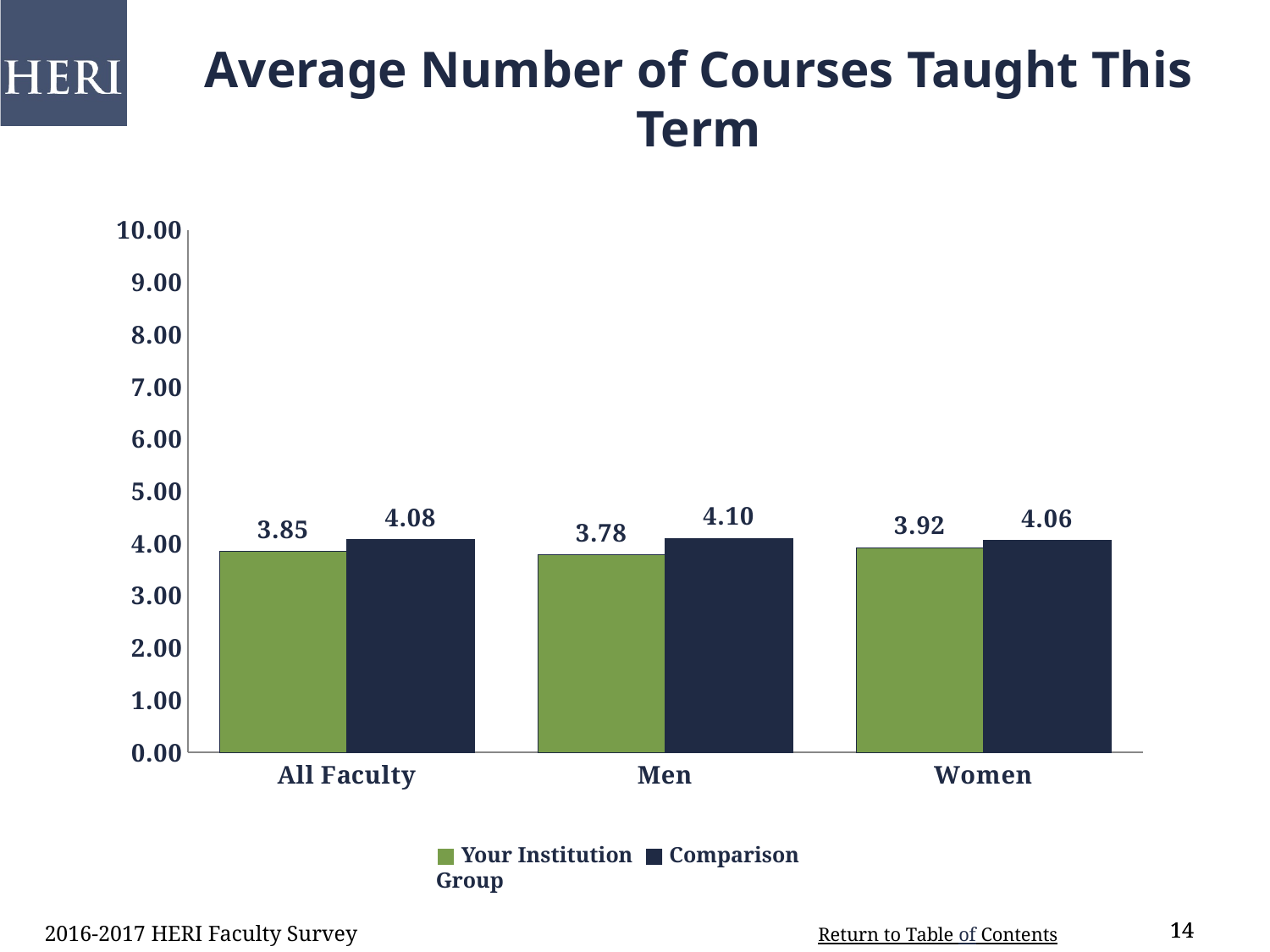
What is the title of the chart? Average Number of Courses Taught This Term How many series does the legend list? 2 What kind of chart is shown on the slide? Bar chart What is the difference between the Comparison Group and Your Institution values for Men? 0.32 For Women, which is larger: Your Institution or Comparison Group? Comparison Group How many categories are shown on the x axis? 3 What is the value for Comparison Group in the Men category? 4.10 Which category has the lowest value for Your Institution? Men Which category has the highest value for Your Institution? Women What is the value for Your Institution in the Women category? 3.92 What is the value for Your Institution in the All Faculty category? 3.85 What is the difference between the Comparison Group and Your Institution values for All Faculty? 0.23